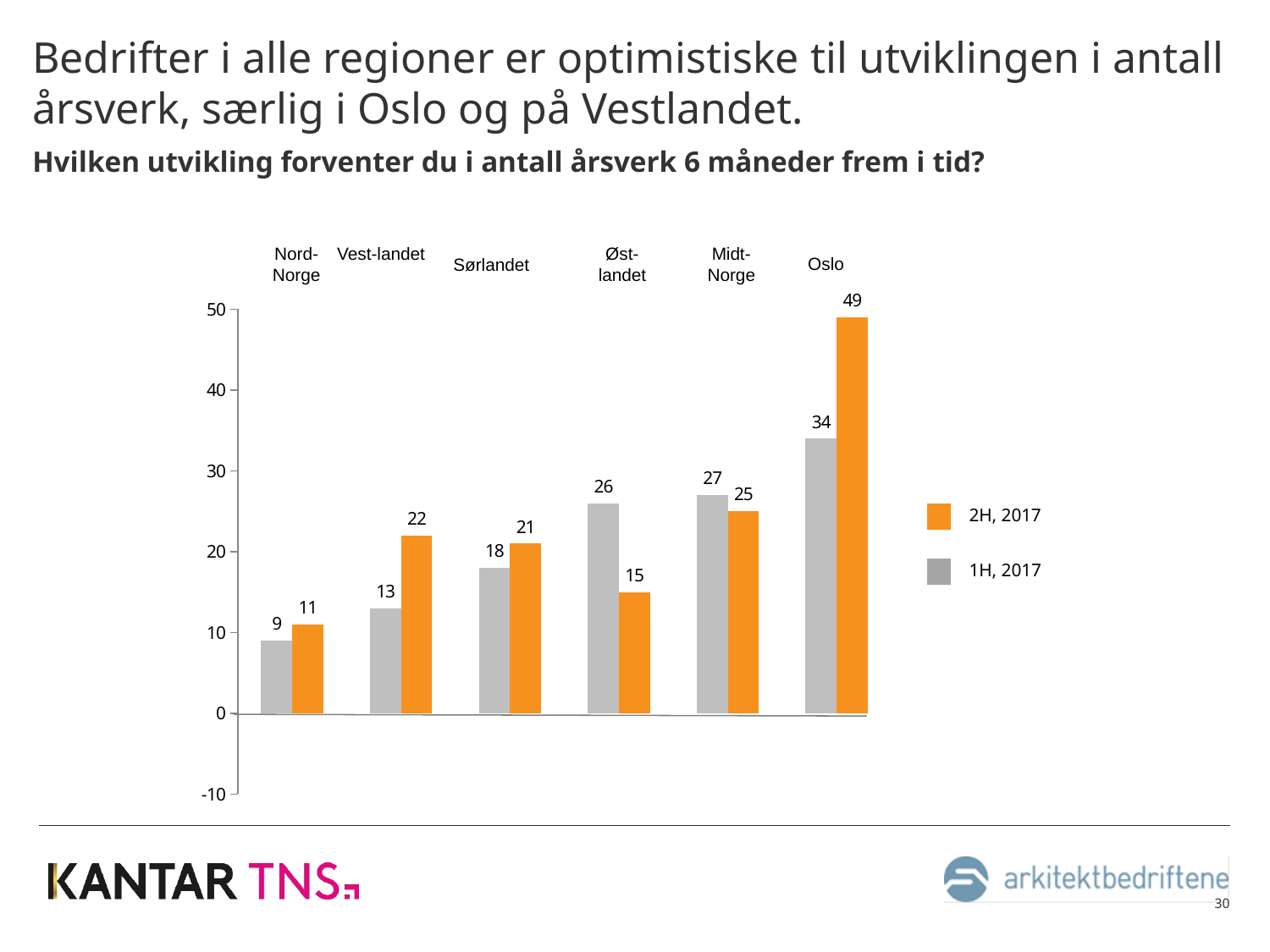
How many regions are shown on the chart? 6 What kind of chart is shown on the slide? Bar chart Which region has the highest value in the 2H, 2017 series? Oslo What is the difference between the 2H, 2017 and 1H, 2017 values for Oslo? 15 How many series does the legend list? 2 What is the value for Oslo in the 2H, 2017 series? 49 What is the value for Nord-Norge in the 1H, 2017 series? 9 Which is larger for Vest-landet: the 1H, 2017 value or the 2H, 2017 value? 2H, 2017 What is the difference between the 1H, 2017 and 2H, 2017 values for Øst-landet? 11 Which region has the lowest value in the 1H, 2017 series? Nord-Norge Which is larger for Midt-Norge: the 1H, 2017 value or the 2H, 2017 value? 1H, 2017 What is the value for Øst-landet in the 1H, 2017 series? 26